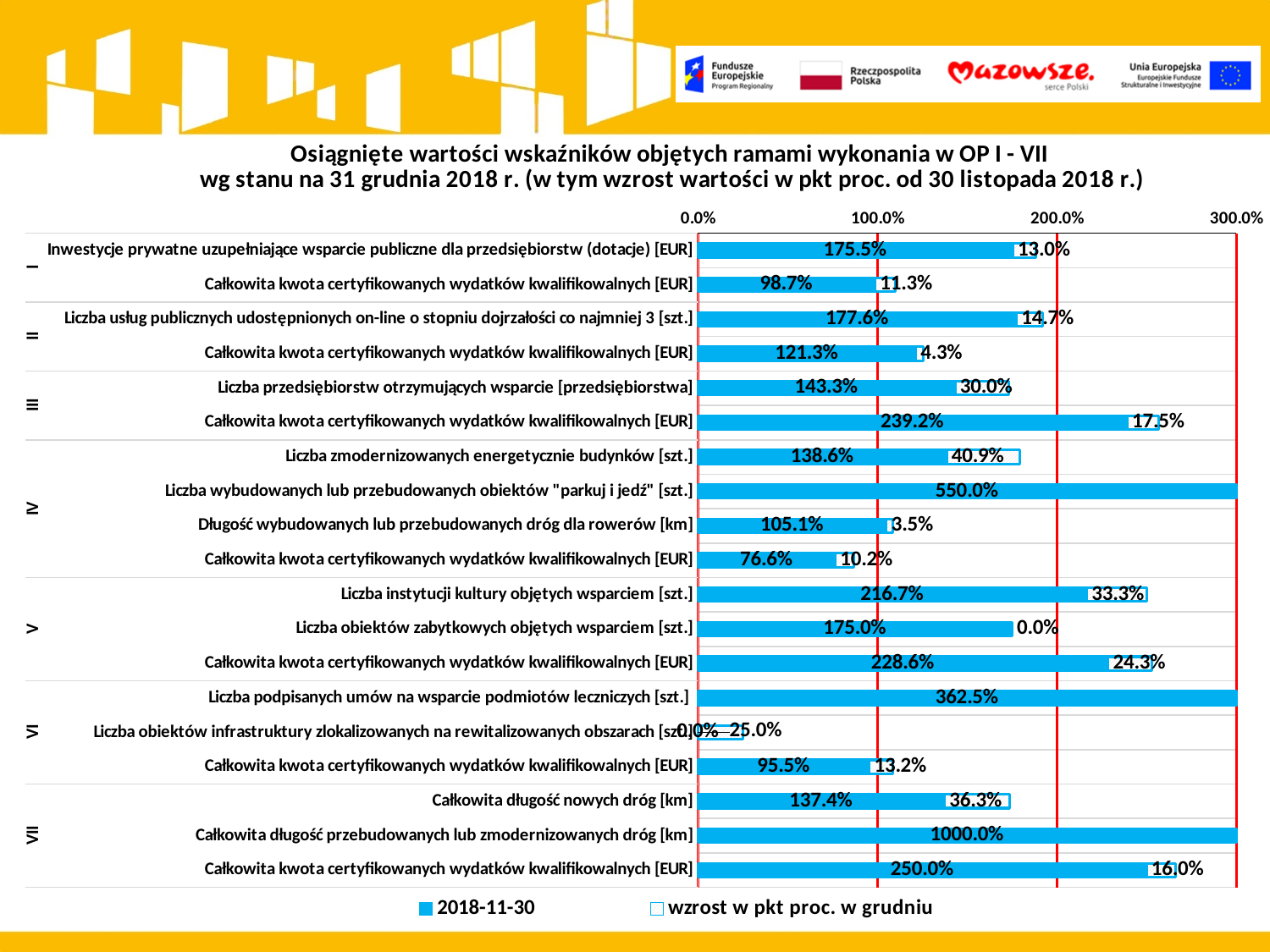
What kind of chart is shown on the slide? Stacked horizontal bar chart How many series does the legend list? 2 What is the difference between the 2018-11-30 values for 'Liczba instytucji kultury objętych wsparciem [szt.]' and 'Liczba obiektów zabytkowych objętych wsparciem [szt.]'? 41.7% How many indicators (categories) are plotted on the chart? 19 What is the 2018-11-30 value for 'Całkowita kwota certyfikowanych wydatków kwalifikowalnych [EUR]' in OP III? 239.2% Which has a larger 2018-11-30 value: 'Całkowita długość nowych dróg [km]' or 'Liczba usług publicznych udostępnionych on-line o stopniu dojrzałości co najmniej 3 [szt.]'? Liczba usług publicznych udostępnionych on-line o stopniu dojrzałości co najmniej 3 [szt.] Which indicator has the lowest 2018-11-30 value? Liczba obiektów infrastruktury zlokalizowanych na rewitalizowanych obszarach [szt.] What are the two legend entries of the chart? 2018-11-30; wzrost w pkt proc. w grudniu Which indicator has the highest 2018-11-30 value? Całkowita długość przebudowanych lub zmodernizowanych dróg [km] What is the total of the stacked bar for 'Całkowita długość nowych dróg [km]'? 173.7% What is the 'wzrost w pkt proc. w grudniu' value for 'Liczba zmodernizowanych energetycznie budynków [szt.]'? 40.9% What is the 2018-11-30 value for 'Liczba przedsiębiorstw otrzymujących wsparcie [przedsiębiorstwa]'? 143.3%